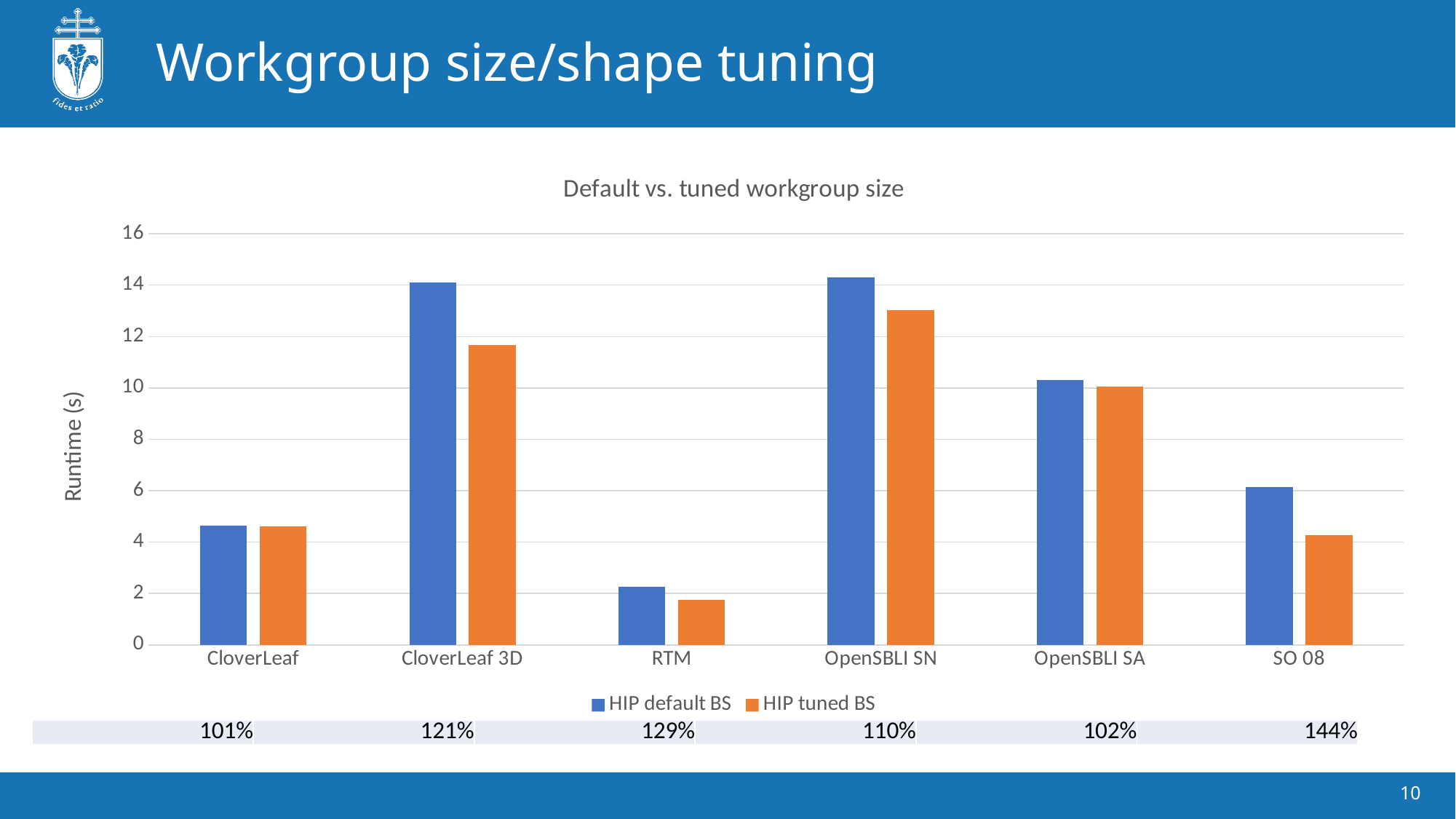
For SO 08, which is larger: the HIP default BS runtime or the HIP tuned BS runtime? HIP default BS What kind of chart is shown on the slide? bar chart Is the HIP tuned BS runtime for SO 08 greater or less than 6? less What is the title of the chart? Default vs. tuned workgroup size For CloverLeaf 3D, which is larger: the HIP default BS runtime or the HIP tuned BS runtime? HIP default BS Is the HIP default BS runtime for OpenSBLI SN greater or less than 12? greater What is the label on the y axis? Runtime (s) Which category has the lowest HIP default BS runtime? RTM Which category has the lowest HIP tuned BS runtime? RTM Which category has the highest HIP tuned BS runtime? OpenSBLI SN How many categories are shown on the x axis? 6 How many series does the legend list? 2